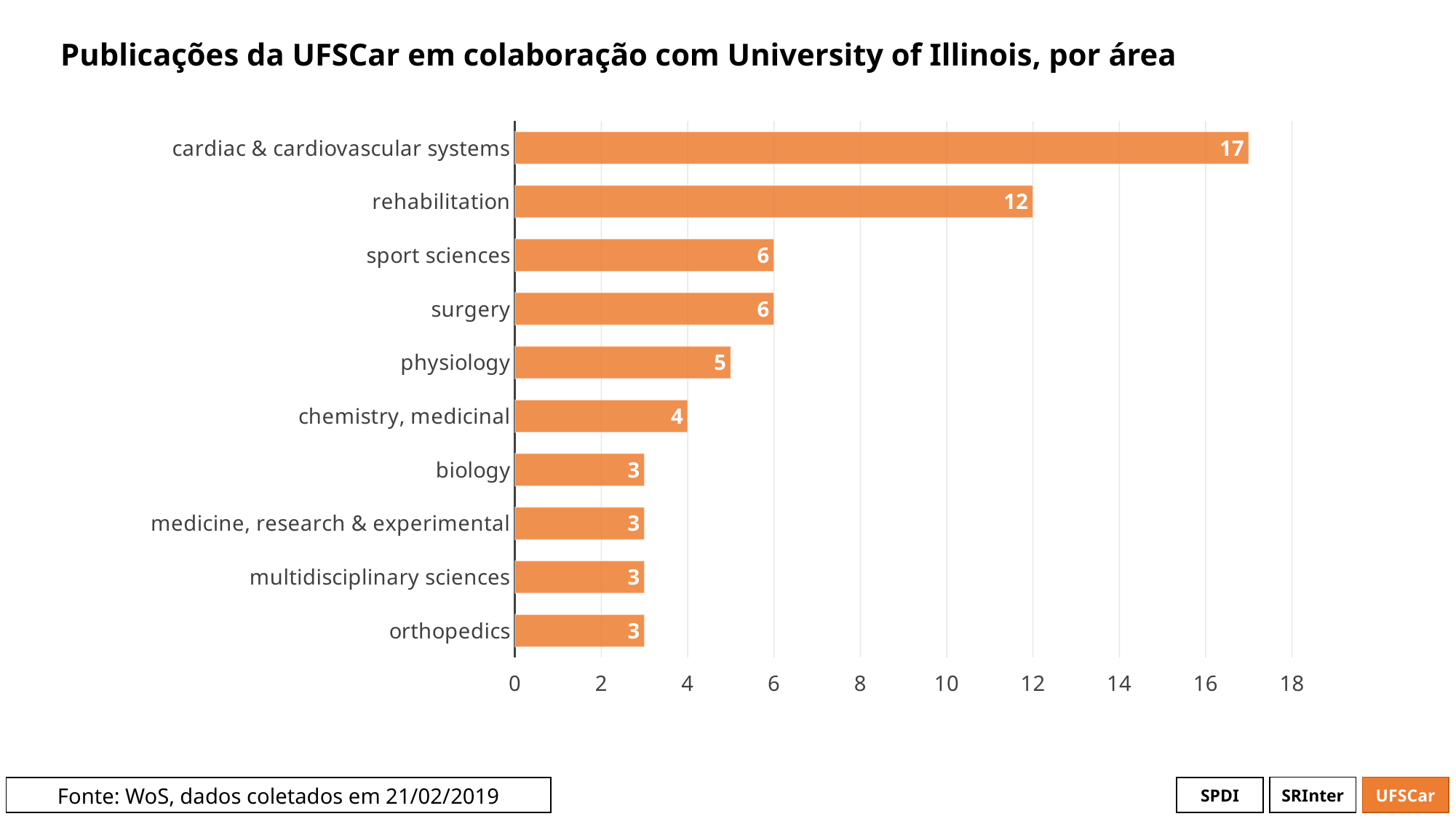
Which is larger, the value for surgery or the value for physiology? surgery What is the value for chemistry, medicinal? 4 How many areas have a value of 3? 4 What is the title of the chart? Publicações da UFSCar em colaboração com University of Illinois, por área What is the value for physiology? 5 What is the difference between cardiac & cardiovascular systems and rehabilitation? 5 What kind of chart is shown on the slide? bar chart How many areas are shown in the chart? 10 Is the value for rehabilitation greater or less than 10? greater What is the difference between sport sciences and biology? 3 What is the value for rehabilitation? 12 Which area has the highest number of publications? cardiac & cardiovascular systems